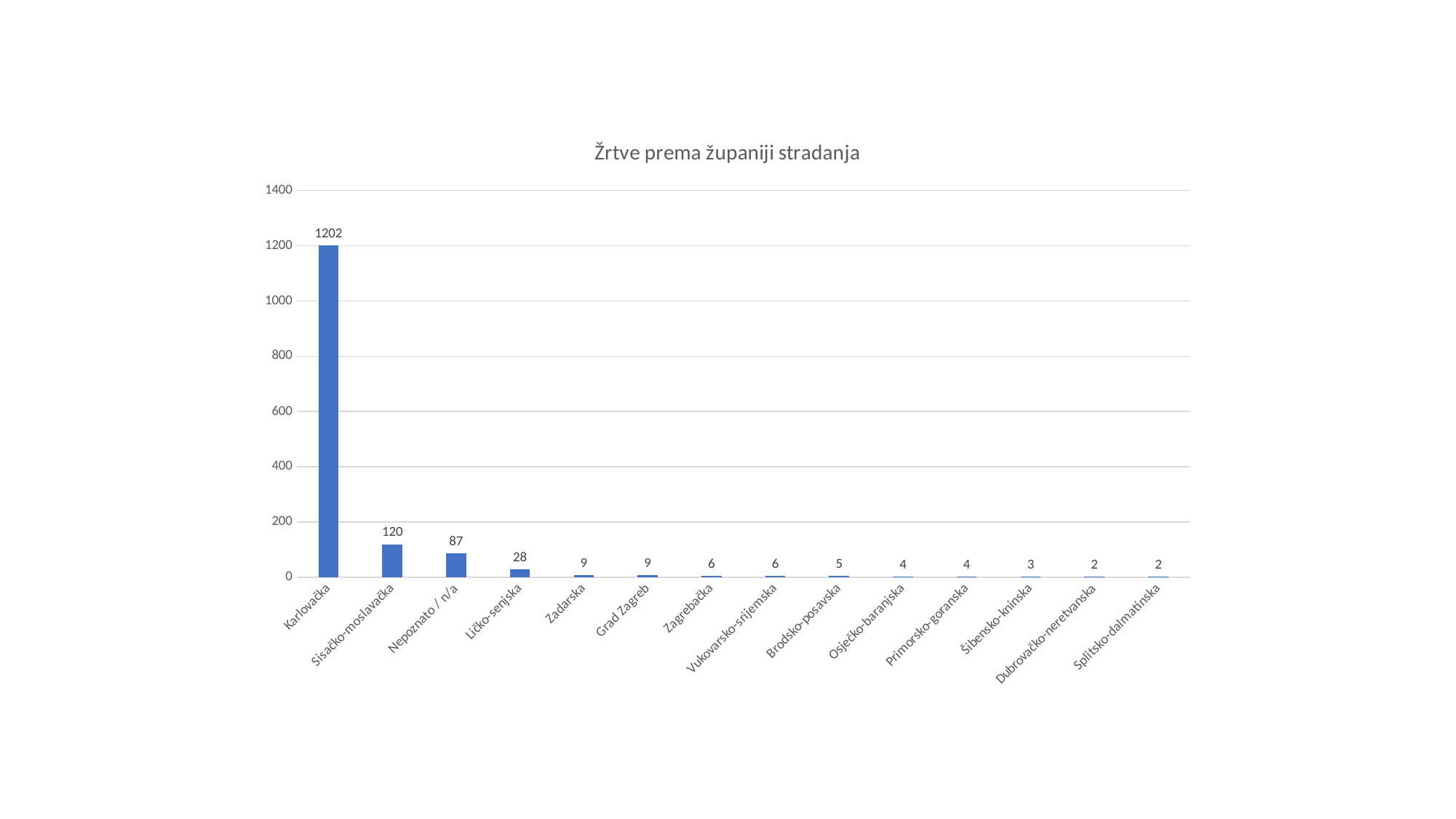
What is the value for Sisačko-moslavačka? 120 What is the difference between the values for Sisačko-moslavačka and Nepoznato / n/a? 33 Which category has the highest value? Karlovačka How many categories are shown on the x axis? 14 Which is larger, the value for Ličko-senjska or the value for Zadarska? Ličko-senjska What kind of chart is shown on the slide? Bar chart What is the value for Nepoznato / n/a? 87 What is the value for Brodsko-posavska? 5 What is the difference between the values for Karlovačka and Sisačko-moslavačka? 1082 What is the title of the chart? Žrtve prema županiji stradanja What is the value for Karlovačka? 1202 What is the value for Ličko-senjska? 28